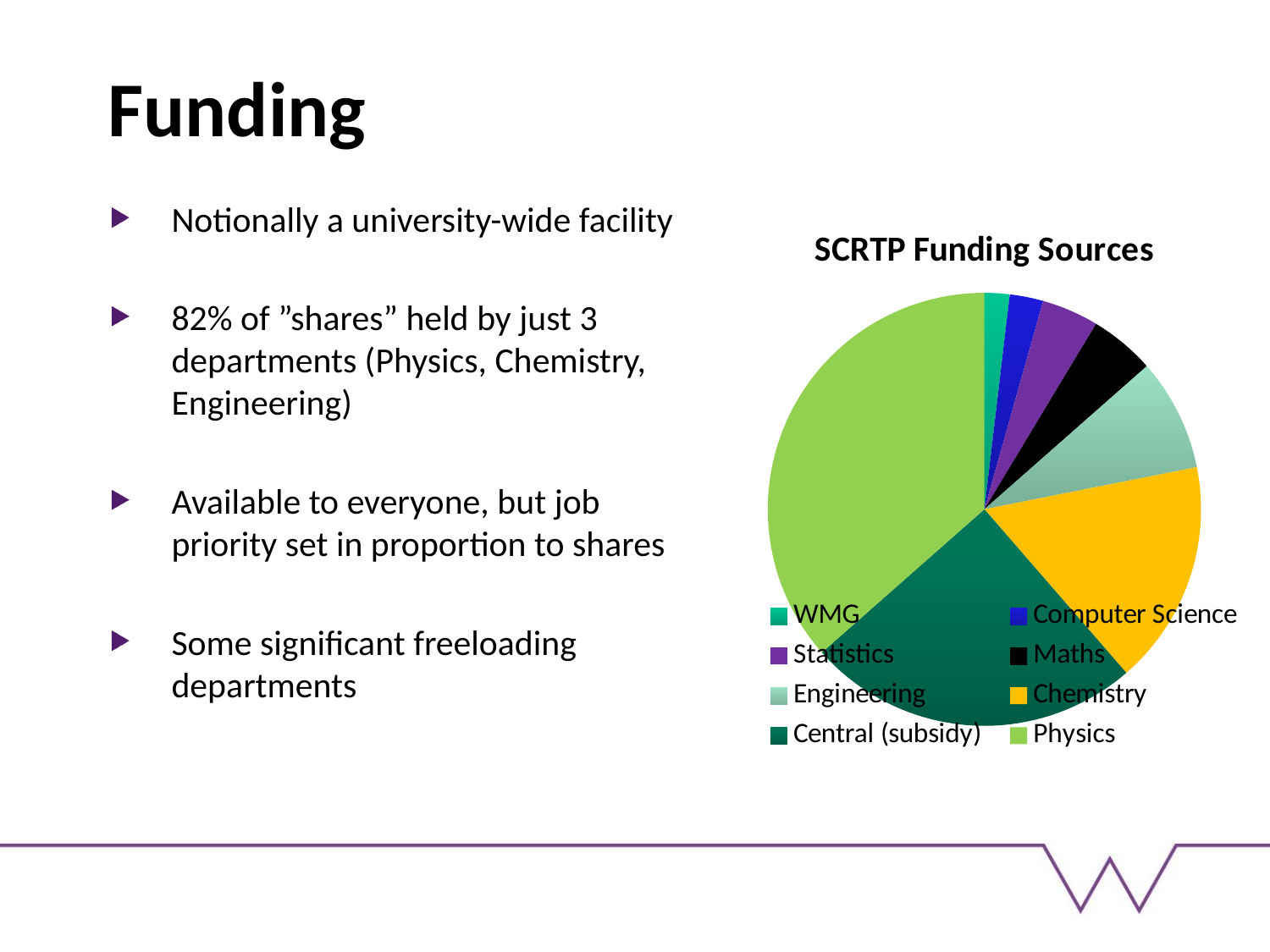
Which slice is larger, Engineering or WMG? Engineering Which category has the smallest slice of the pie? WMG Which slice is larger, Physics or Central (subsidy)? Physics What colour is the Chemistry slice in the pie chart? yellow Which slice is larger, Central (subsidy) or Chemistry? Central (subsidy) What kind of chart is shown on the slide? pie chart How many categories (slices) does the pie chart have? 8 Which category has the largest slice of the pie? Physics What is the title of the chart? SCRTP Funding Sources